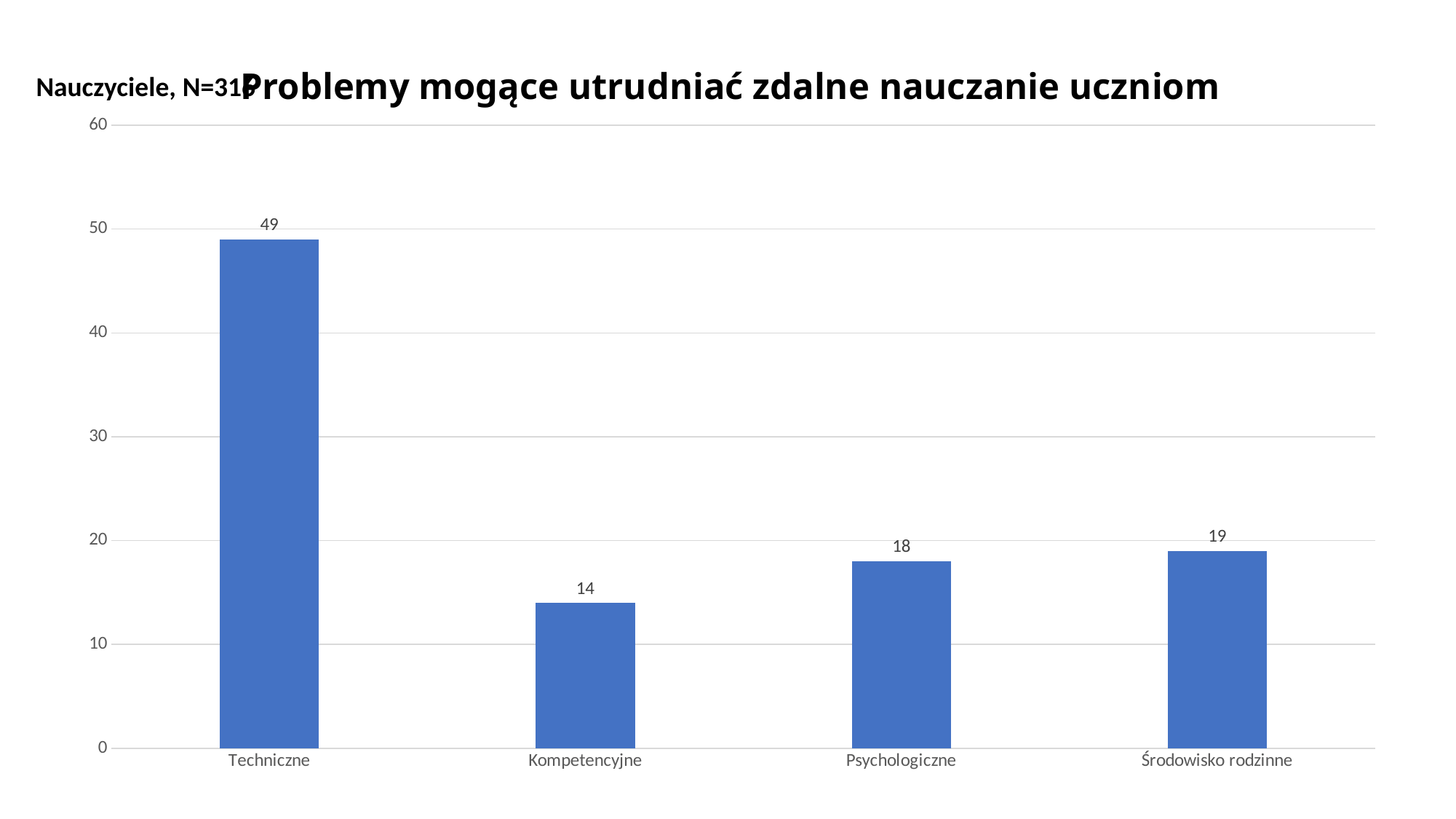
What kind of chart is shown on the slide? bar chart How many categories are shown on the x axis? 4 What is the value for Techniczne? 49 Which is larger, the value for Psychologiczne or the value for Kompetencyjne? Psychologiczne What is the value for Psychologiczne? 18 What is the value for Środowisko rodzinne? 19 Is the value for Techniczne greater or less than 40? greater What is the value for Kompetencyjne? 14 What is the difference between the values for Środowisko rodzinne and Psychologiczne? 1 Which category has the lowest value? Kompetencyjne What is the difference between the values for Techniczne and Kompetencyjne? 35 Which category has the highest value? Techniczne